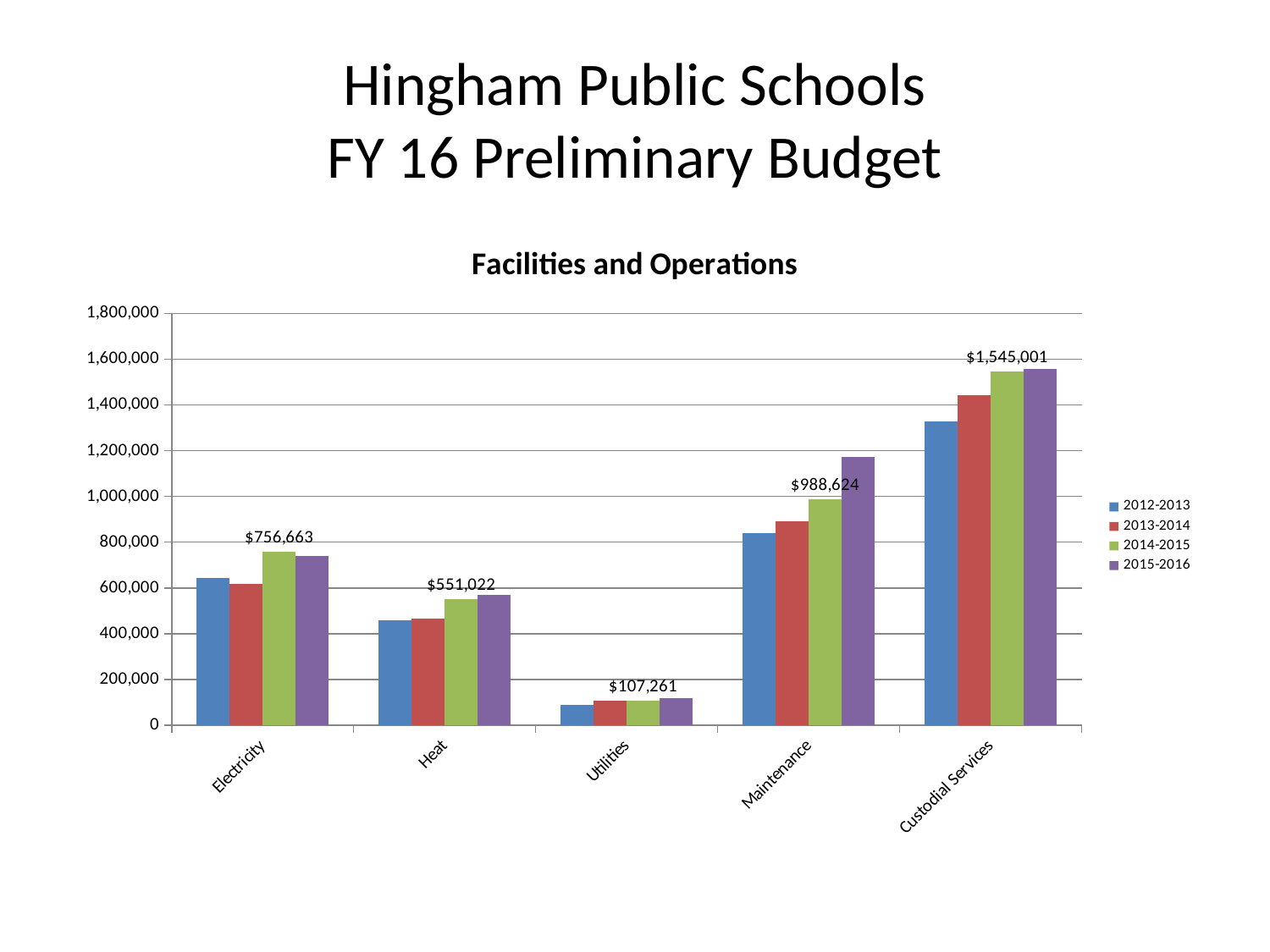
How many series does the legend of the Facilities and Operations chart list? 4 Which is larger for Electricity: the 2012-2013 value or the 2013-2014 value? 2012-2013 Which category has the lowest 2014-2015 value? Utilities How many categories are shown on the x axis of the Facilities and Operations chart? 5 What is the difference between the labelled 2014-2015 values for Maintenance and Heat? $437,602 Is the 2015-2016 value for Maintenance greater or less than 1,000,000? greater What is the labelled 2014-2015 value for Utilities? $107,261 What kind of chart is shown under the title "Facilities and Operations"? bar chart What is the labelled 2014-2015 value for Custodial Services? $1,545,001 What is the labelled 2014-2015 value for Heat? $551,022 What is the labelled 2014-2015 value for Electricity? $756,663 Which category has the highest 2014-2015 value? Custodial Services